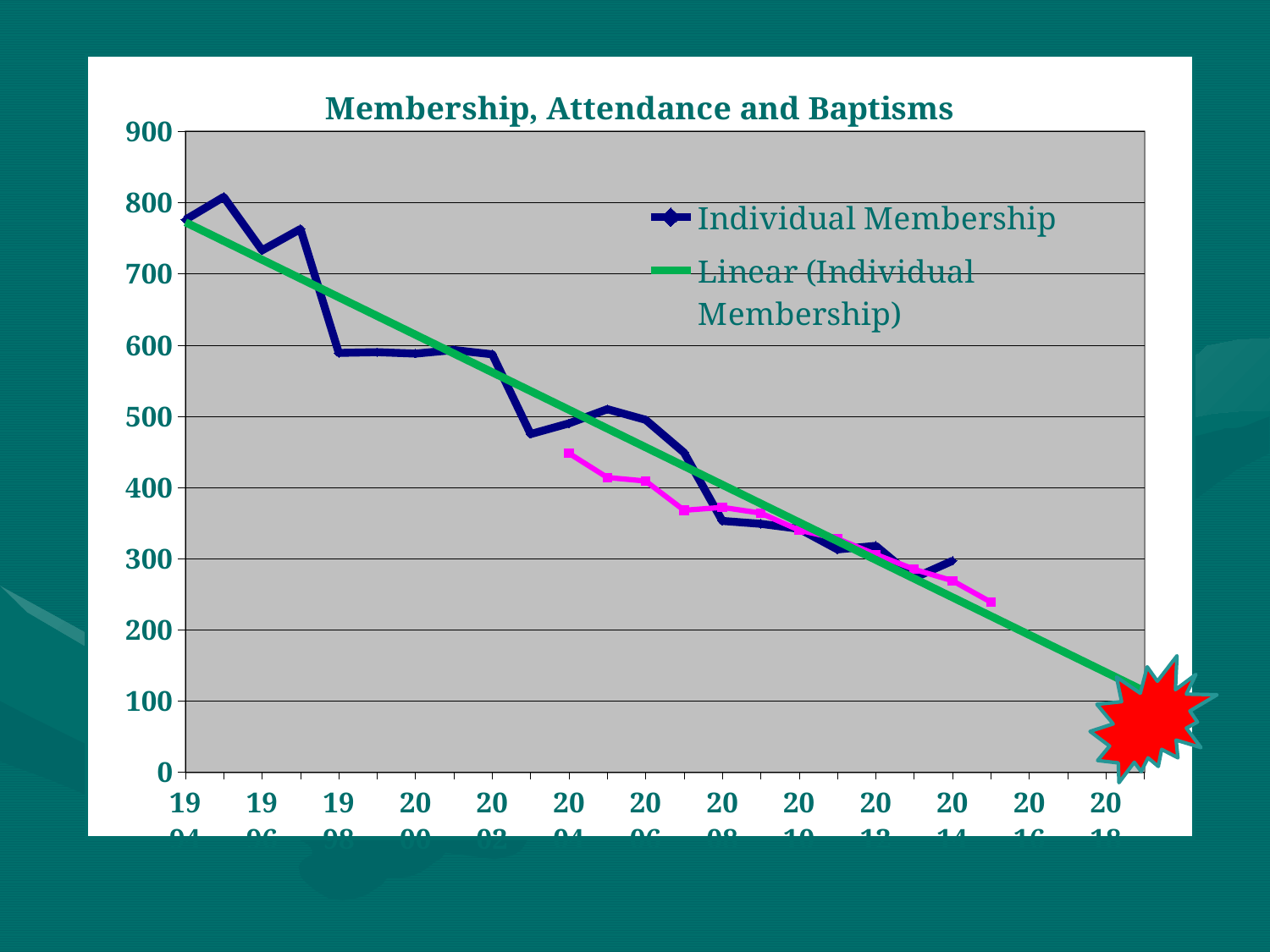
Is the lowest point of the Individual Membership line greater or less than 400? less Is the rightmost point of the magenta line greater or less than 300? less What kind of chart is shown on the slide? line chart Is the leftmost value of the Individual Membership line greater or less than 700? greater What colour is the Individual Membership line in the legend? dark blue Does the Individual Membership line generally rise or fall from left to right? fall How many series does the chart's legend list? 2 Does the Linear (Individual Membership) trend line rise or fall from left to right? fall What is the title of the chart? Membership, Attendance and Baptisms What is the maximum value shown on the vertical axis? 900